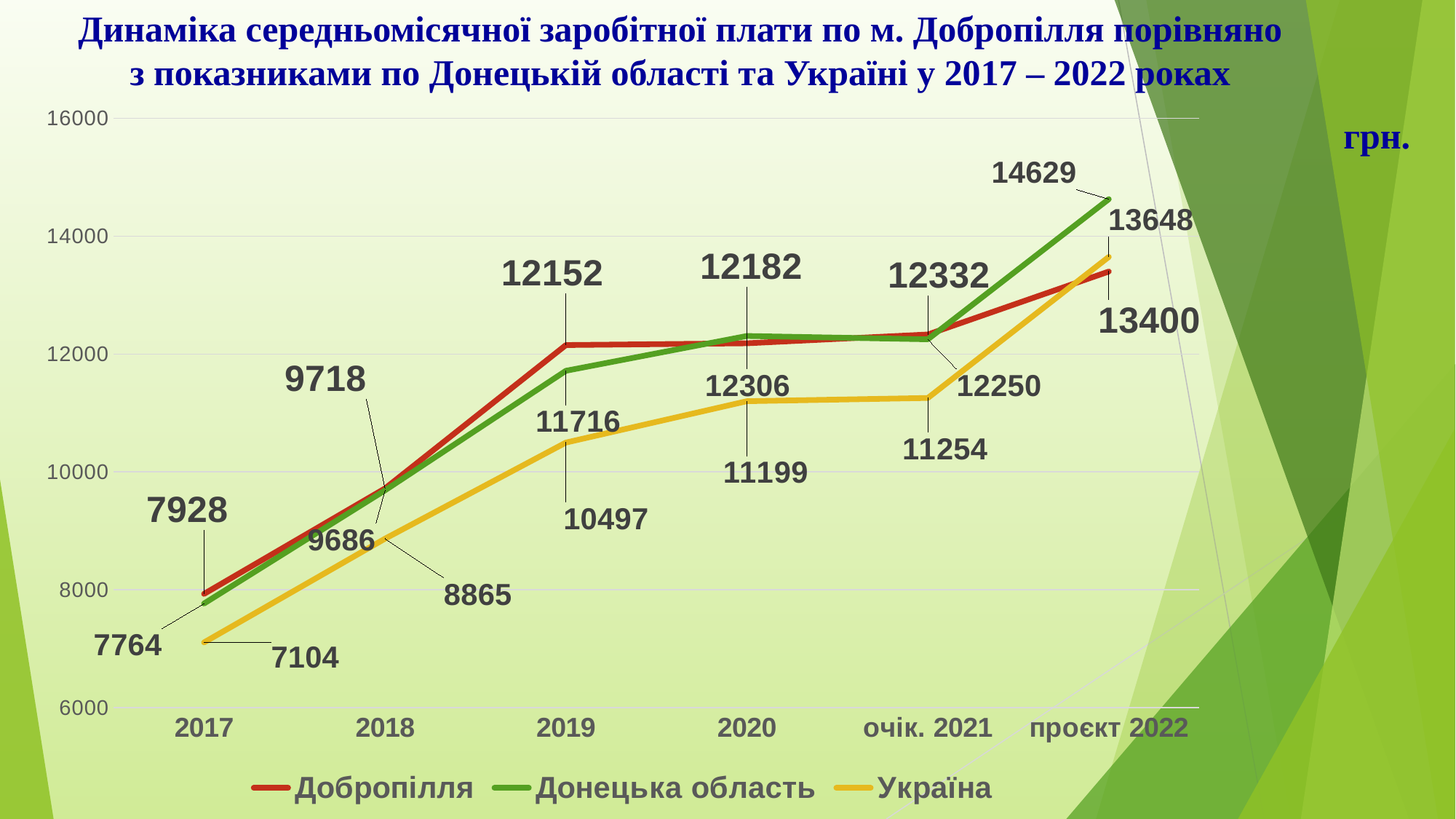
What is the value for Добропілля in очік. 2021? 12332 What is the value for Донецька область in проєкт 2022? 14629 Does the Україна series rise or fall from 2017 to проєкт 2022? rise Which is larger in 2020: the value for Добропілля or for Донецька область? Донецька область Which series has the lowest value in 2018? Україна What is the value for Україна in 2019? 10497 What is the value for Добропілля in 2017? 7928 How many points along the x axis does the chart have? 6 What type of chart is shown on the slide? line chart What is the difference between the Добропілля and Україна values in 2019? 1655 Which series has the highest value in проєкт 2022? Донецька область How many series does the legend list? 3